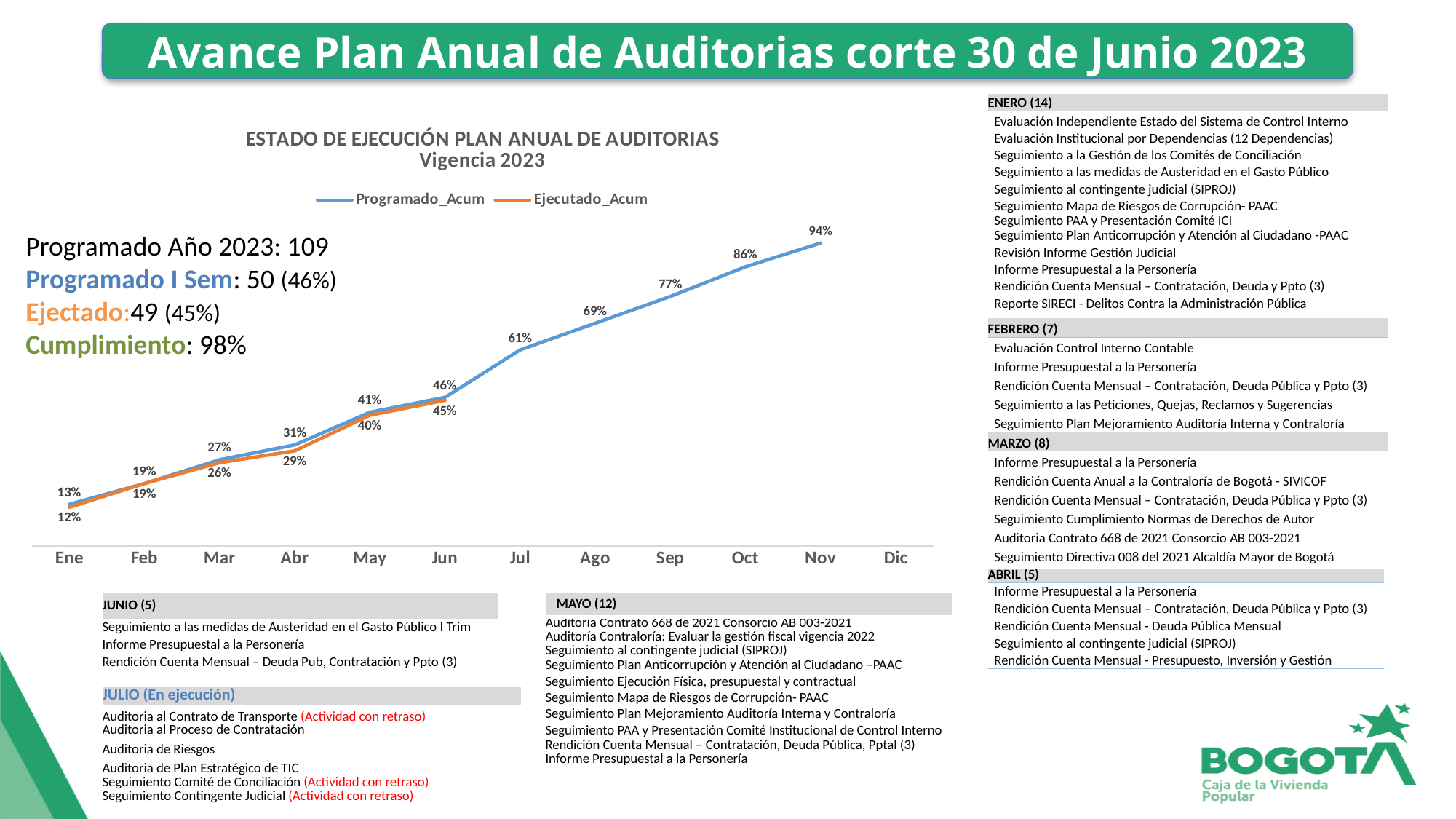
What is the Ejecutado_Acum value for Abr? 29% Does the Programado_Acum series rise or fall from Ene to Nov? rise How many series does the chart legend list? 2 In which month does the Programado_Acum series reach its highest labelled value? Nov Which is larger in Mar, Programado_Acum or Ejecutado_Acum? Programado_Acum What is the title of the chart? ESTADO DE EJECUCIÓN PLAN ANUAL DE AUDITORIAS Vigencia 2023 What is the Programado_Acum value for Jun? 46% What is the Ejecutado_Acum value for Jun? 45% What type of chart is shown on the slide? line chart What is the difference between the Programado_Acum and Ejecutado_Acum values for May? 1% What is the Programado_Acum value for Nov? 94% Which month has the lowest Ejecutado_Acum value? Ene